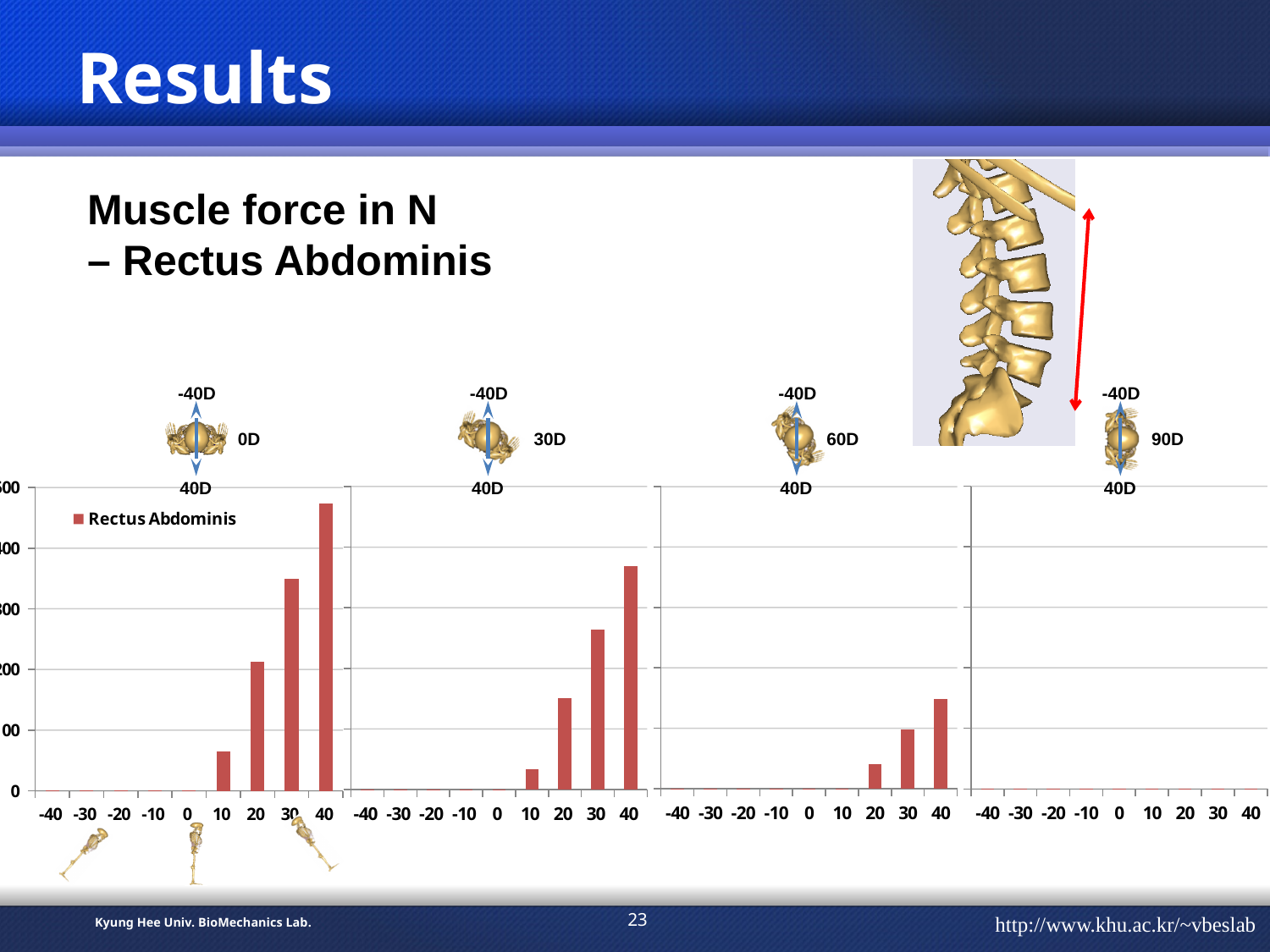
Which is larger: the value at 40 in the 0D chart or the value at 40 in the 30D chart? 0D chart How many series does the legend on the 0D chart list? 1 In the 0D chart, which x-axis category has the highest bar? 40 How many bar charts are shown on the slide? 4 In the 0D chart, is the value at 10 greater or less than 100? less What is the series name shown in the legend of the 0D chart? Rectus Abdominis In the 60D chart, is the value at 40 greater or less than 100? greater What kind of chart is the 0D chart? bar chart In the 0D chart, is the value at 40 greater or less than 400? greater How many categories are on the x axis of the 0D chart? 9 In the 0D chart, do the bar values rise or fall from 10 to 40 along the x axis? rise